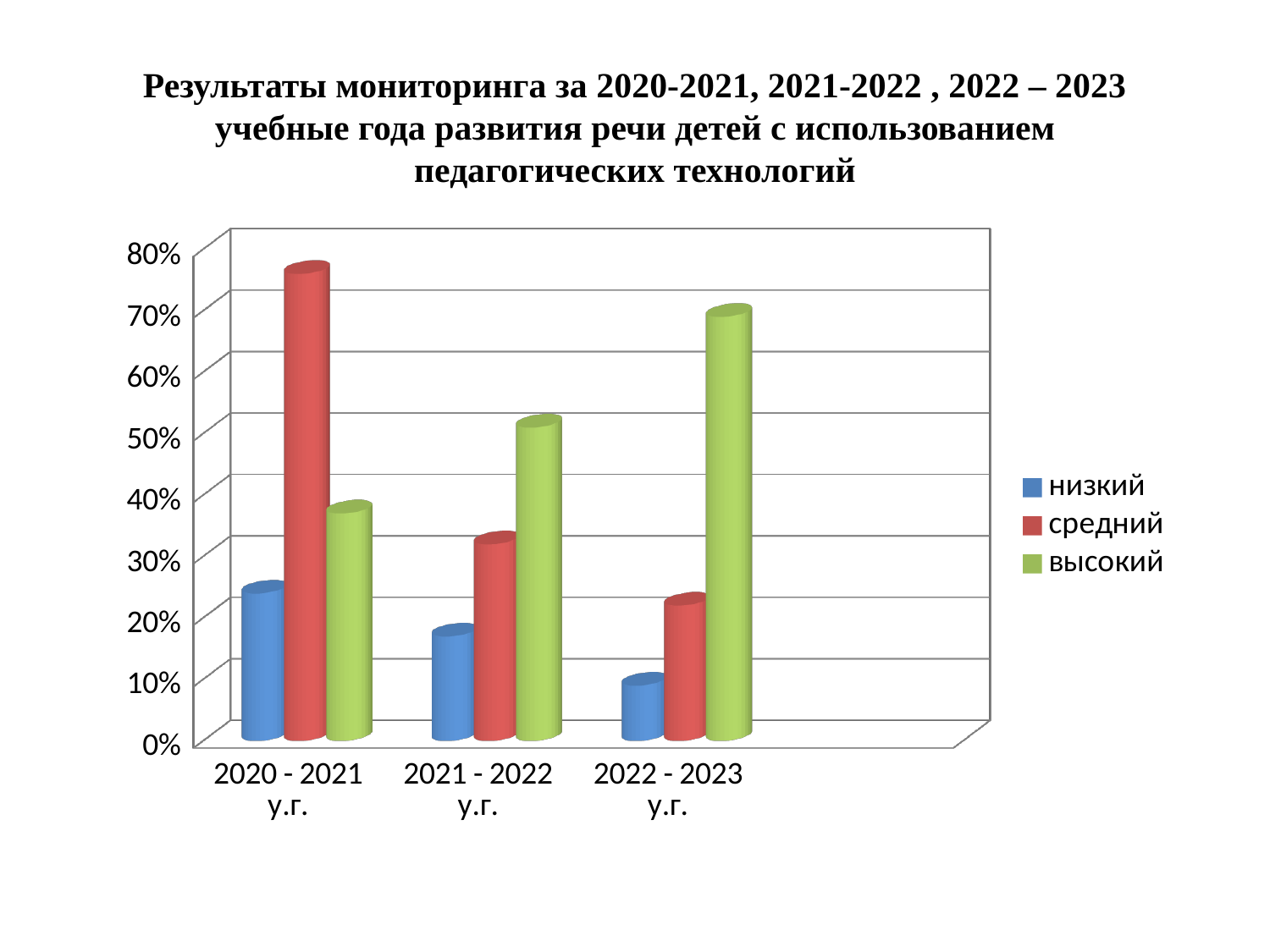
How many series does the legend list? 3 Which series has the lowest value in 2022 - 2023 у.г.? низкий Which is larger: the value for высокий in 2021 - 2022 у.г. or in 2022 - 2023 у.г.? 2022 - 2023 у.г. Does the value for высокий rise or fall from 2020 - 2021 у.г. to 2022 - 2023 у.г.? rise Which series has the highest value in 2022 - 2023 у.г.? высокий Is the value for низкий in 2022 - 2023 у.г. greater or less than 20%? less What kind of chart is shown on the slide? bar chart How many academic-year categories are shown on the x axis? 3 Is the value for высокий in 2022 - 2023 у.г. greater or less than 60%? greater Is the value for средний in 2020 - 2021 у.г. greater or less than 70%? greater Does the value for низкий rise or fall from 2020 - 2021 у.г. to 2022 - 2023 у.г.? fall Which series has the highest value in 2020 - 2021 у.г.? средний